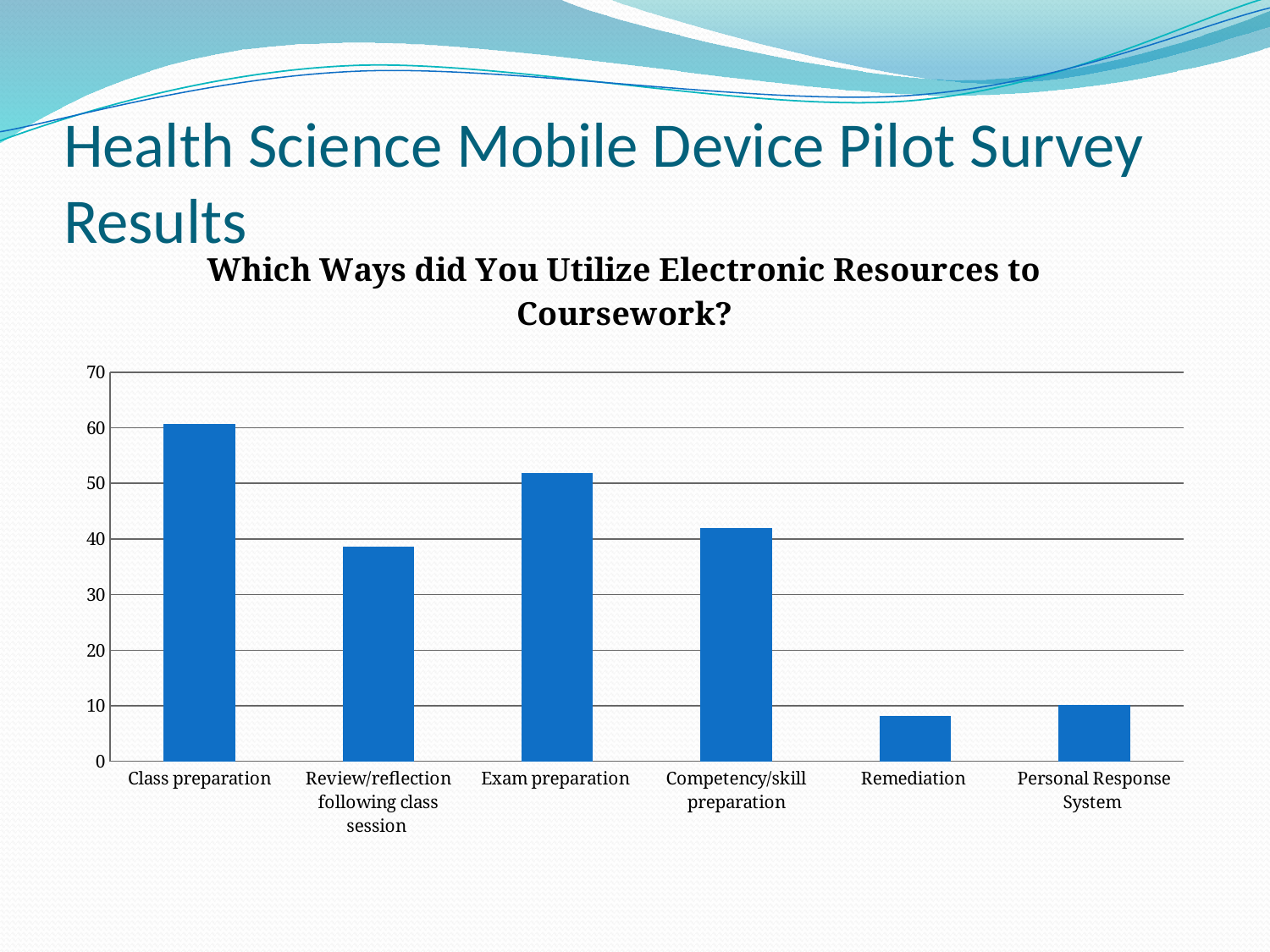
How many categories are shown on the x axis of the chart? 6 Is the value for Remediation greater or less than 10? less What is the title of the chart? Which Ways did You Utilize Electronic Resources to Coursework? Which category has the lowest value? Remediation Is the value for Competency/skill preparation greater or less than 50? less Which is larger, the value for Exam preparation or the value for Competency/skill preparation? Exam preparation Is the value for Class preparation greater or less than 50? greater What kind of chart is shown on the slide? Bar chart Which category has the highest value? Class preparation Which is larger, the value for Class preparation or the value for Review/reflection following class session? Class preparation